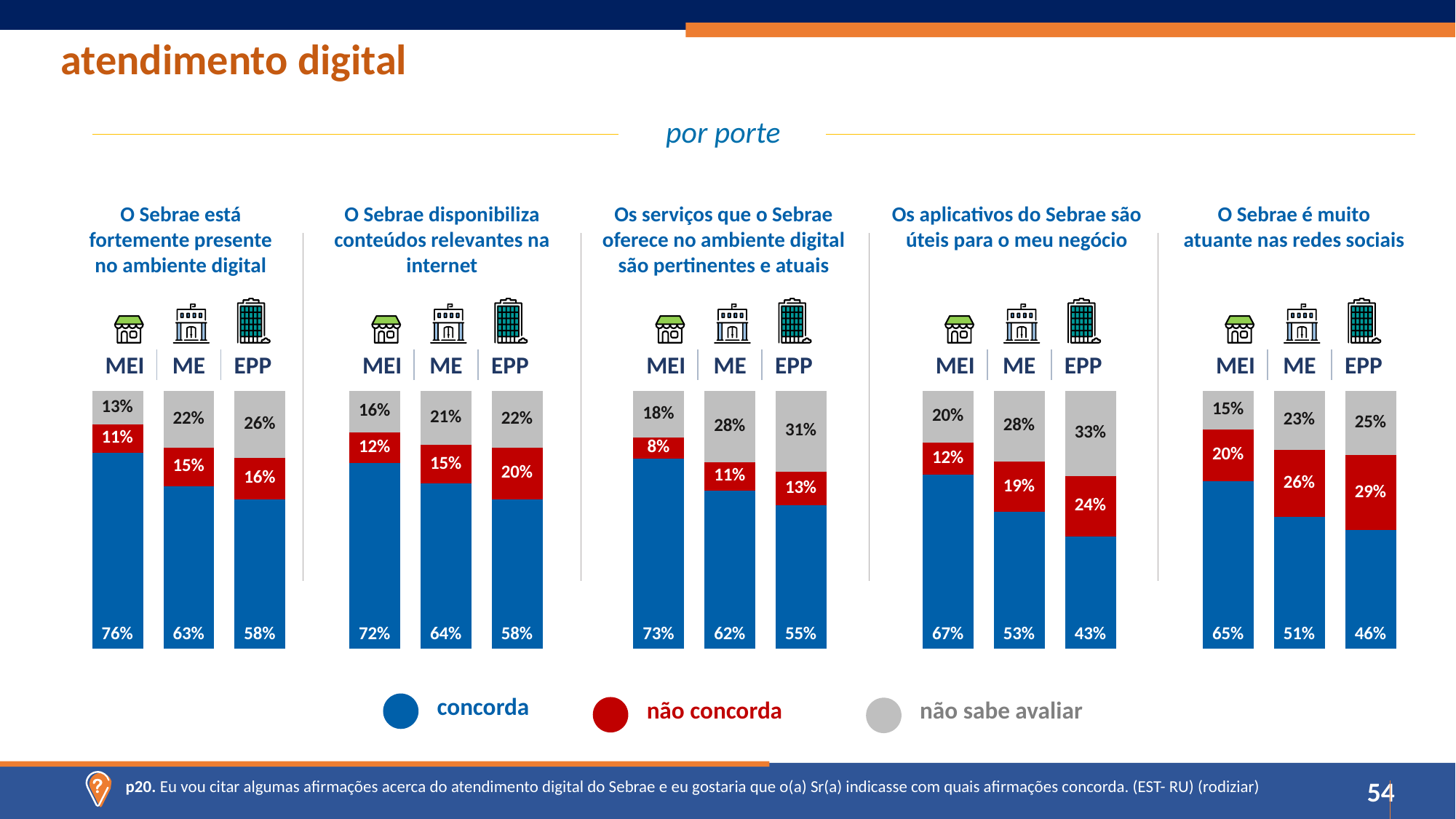
In the chart titled 'Os serviços que o Sebrae oferece no ambiente digital são pertinentes e atuais', which category has the lowest 'concorda' value? EPP In the chart titled 'Os aplicativos do Sebrae são úteis para o meu negócio', what is the difference between the 'concorda' values for MEI and EPP? 24% In the chart titled 'Os aplicativos do Sebrae são úteis para o meu negócio', do the 'concorda' values rise or fall from MEI to EPP? Fall How many categories are shown in the chart titled 'Os serviços que o Sebrae oferece no ambiente digital são pertinentes e atuais'? 3 How many series does the legend at the bottom of the slide list? 3 In the chart titled 'O Sebrae disponibiliza conteúdos relevantes na internet', which category has the highest 'concorda' value? MEI In the chart titled 'O Sebrae está fortemente presente no ambiente digital', what is the 'concorda' value for MEI? 76% In the chart titled 'Os aplicativos do Sebrae são úteis para o meu negócio', what is the 'não sabe avaliar' value for EPP? 33% In the chart titled 'O Sebrae está fortemente presente no ambiente digital', what is the total of the stacked bar for ME? 100% In the chart titled 'O Sebrae é muito atuante nas redes sociais', which is larger: the 'não concorda' value for EPP or the 'não sabe avaliar' value for EPP? não concorda (29%) In the chart titled 'O Sebrae é muito atuante nas redes sociais', what is the 'não concorda' value for ME? 26% What kind of chart is used for 'O Sebrae disponibiliza conteúdos relevantes na internet'? Stacked bar chart